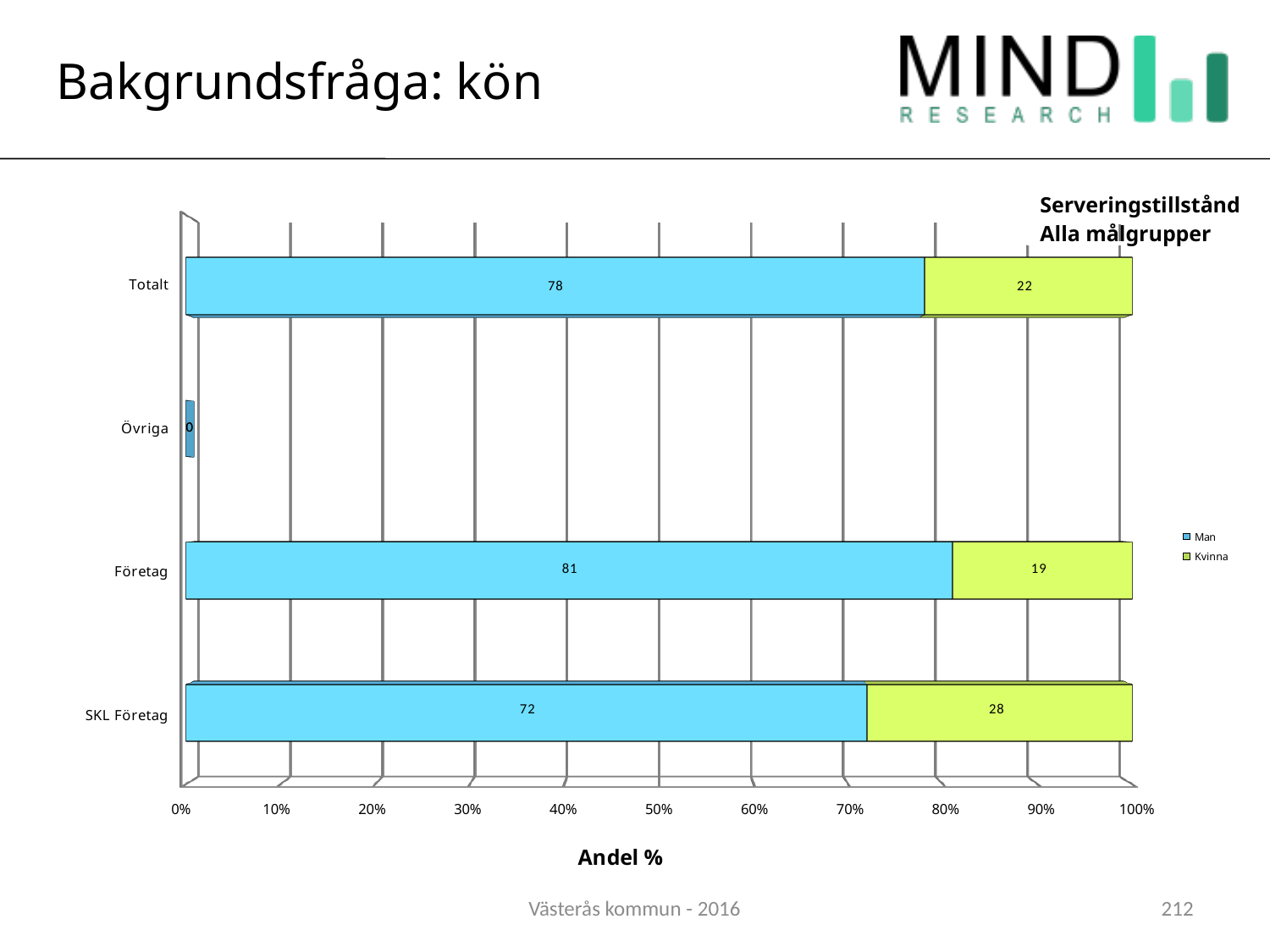
How many series does the legend list? 2 How many categories are shown on the y axis? 4 What is the value for Man in the Övriga category? 0 Which category has the lowest value for Kvinna among those with a printed Kvinna value? Företag What is the value for Kvinna in the SKL Företag category? 28 What is the value for Man in the Totalt category? 78 Which category has the highest value for Man? Företag What is the difference between the Man values for Företag and SKL Företag? 9 Which is larger: the Kvinna value for Totalt or the Kvinna value for SKL Företag? SKL Företag What is the value for Kvinna in the Företag category? 19 What is the total of the stacked bar for Företag? 100 What kind of chart is shown on the slide? Bar chart